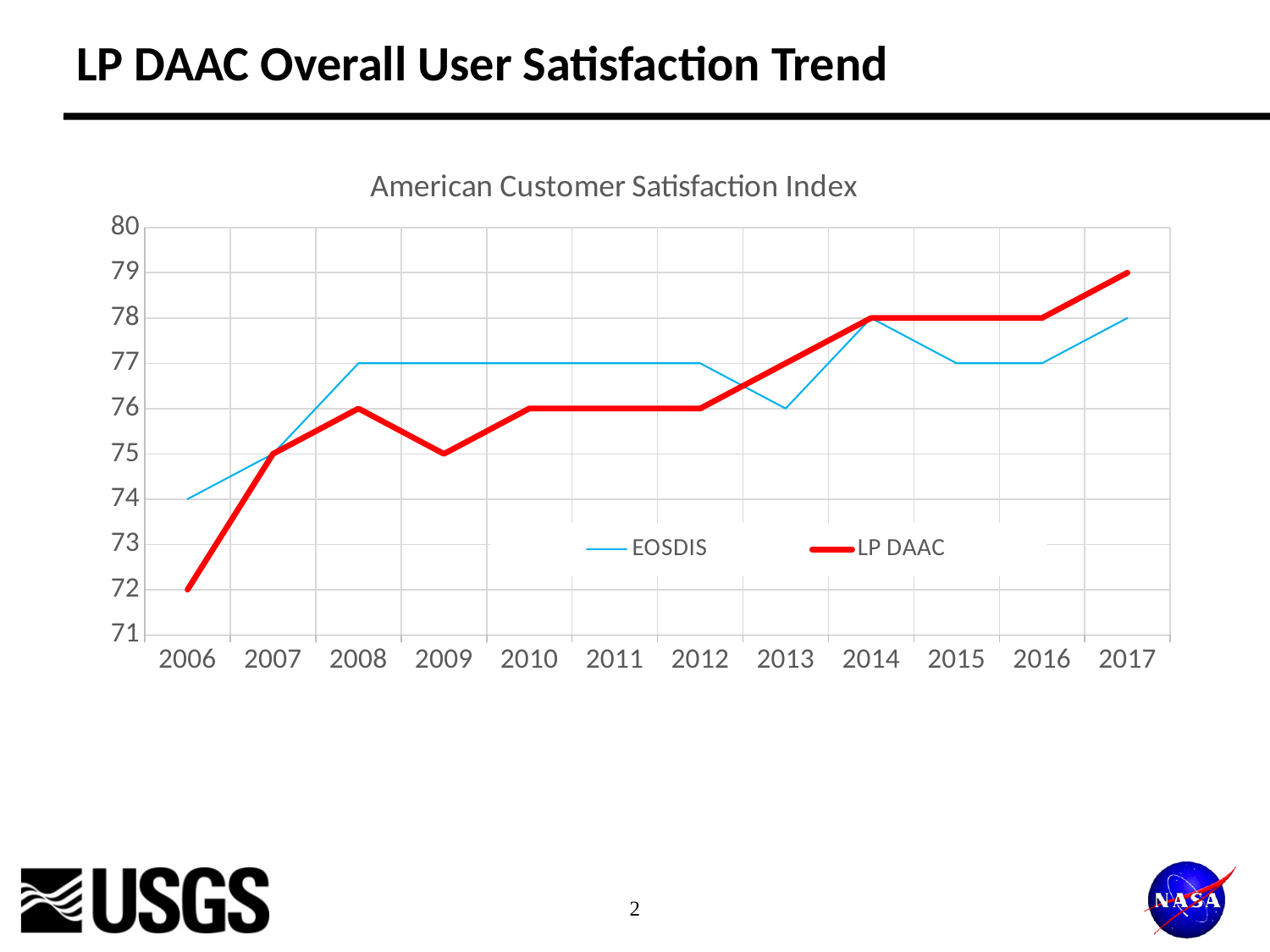
What kind of chart is shown on the slide? Line chart What is the LP DAAC value for 2017? 79 What is the EOSDIS value for 2006? 74 In which year is the LP DAAC value lowest? 2006 What is the LP DAAC value for 2006? 72 In which year is the LP DAAC value highest? 2017 Which series has the higher value in 2013, EOSDIS or LP DAAC? LP DAAC How many series does the legend list? 2 What is the title of the chart? American Customer Satisfaction Index How many years are shown on the x axis? 12 What is the difference between the LP DAAC values for 2017 and 2006? 7 Does the LP DAAC line generally rise or fall from 2006 to 2017? Rise